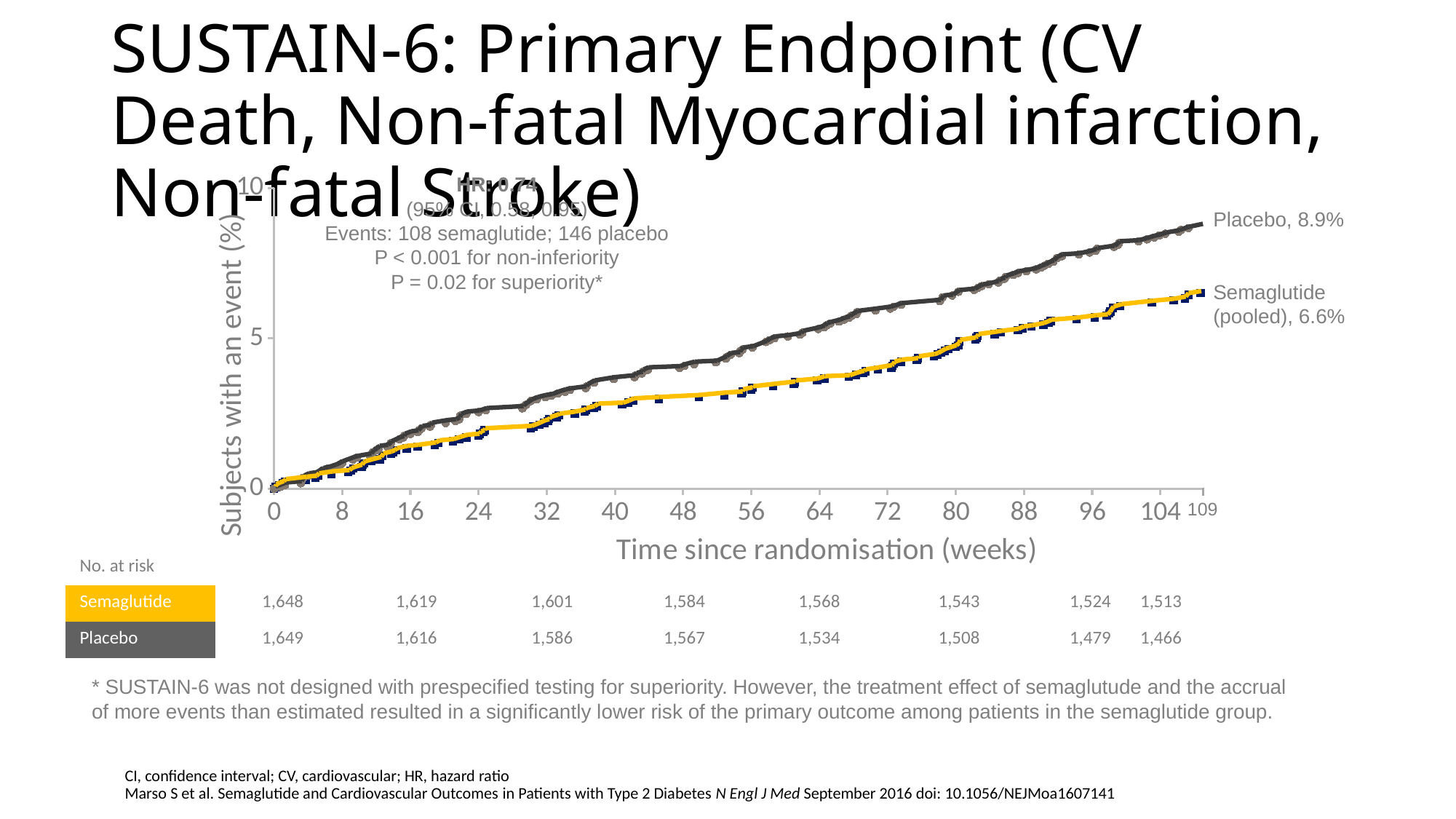
How many treatment groups are plotted on the chart? 2 Do the curves rise or fall as time since randomisation increases? Rise What is the final value shown for the Placebo curve? 8.9% Is the value for the Placebo curve at week 40 greater or less than 5? less What is the number at risk for the Semaglutide group at week 0? 1,648 Is the value for the Semaglutide (pooled) curve at week 104 greater or less than 5? greater What is the final value shown for the Semaglutide (pooled) curve? 6.6% What kind of chart is shown on the slide? Line chart What is the label of the x axis? Time since randomisation (weeks) What is the difference between the final Placebo value and the final Semaglutide (pooled) value? 2.3% How many events are reported for the placebo group in the chart annotation? 146 Which curve ends higher, Placebo or Semaglutide (pooled)? Placebo